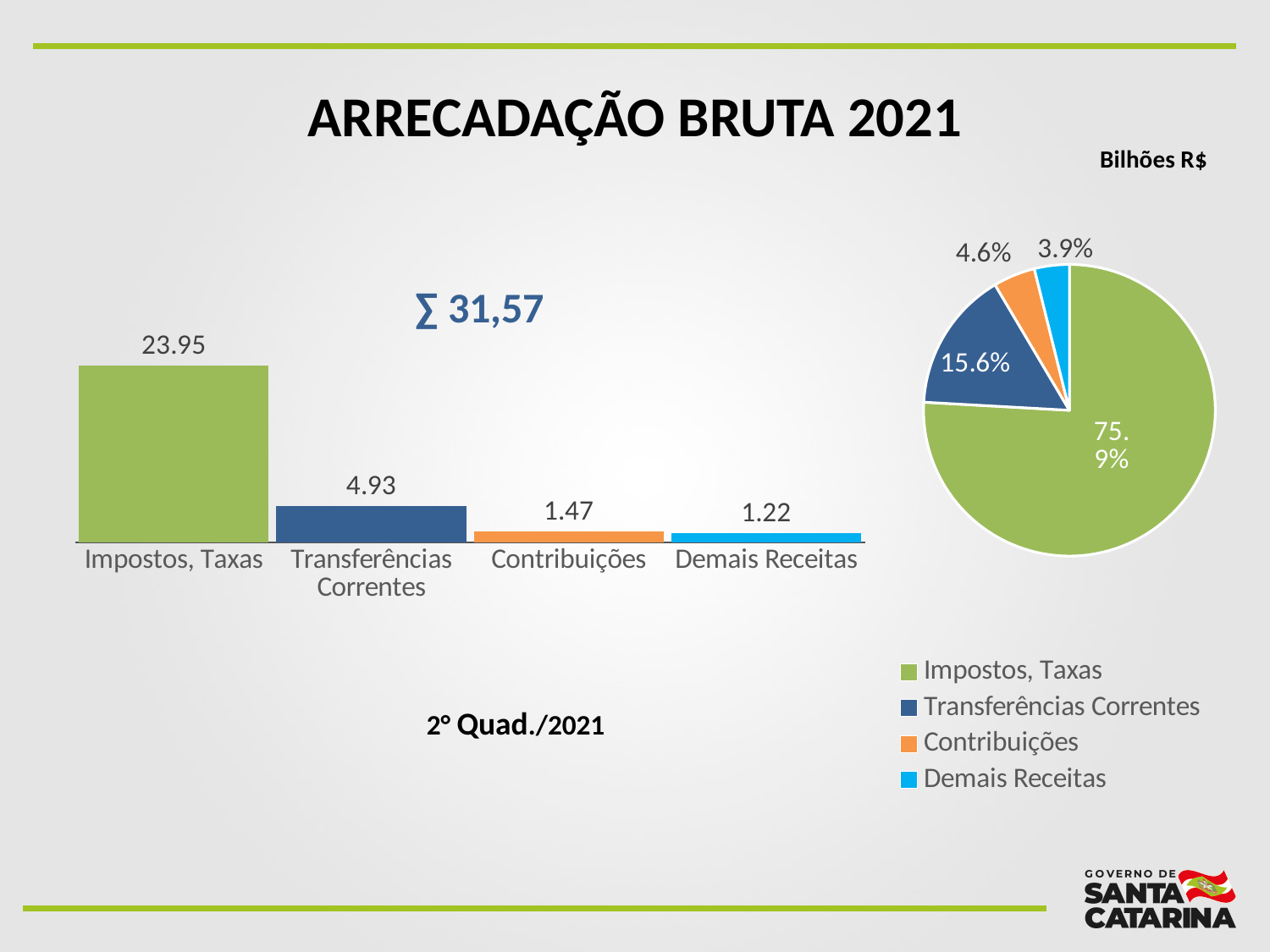
In the bar chart on the left, what is the value for Transferências Correntes? 4.93 In the bar chart on the left, what is the value for Contribuições? 1.47 In the bar chart on the left, which category has the highest value? Impostos, Taxas What kind of chart is on the left of the slide? Bar chart In the pie chart on the right, what share does Impostos, Taxas have? 75.9% In the bar chart on the left, which is larger: Contribuições or Demais Receitas? Contribuições In the bar chart on the left, what is the value for Impostos, Taxas? 23.95 In the pie chart on the right, what share does Transferências Correntes have? 15.6% How many categories does the bar chart on the left show? 4 In the bar chart on the left, what is the difference between Impostos, Taxas and Transferências Correntes? 19.02 In the bar chart on the left, which category has the lowest value? Demais Receitas How many entries does the legend of the pie chart on the right list? 4